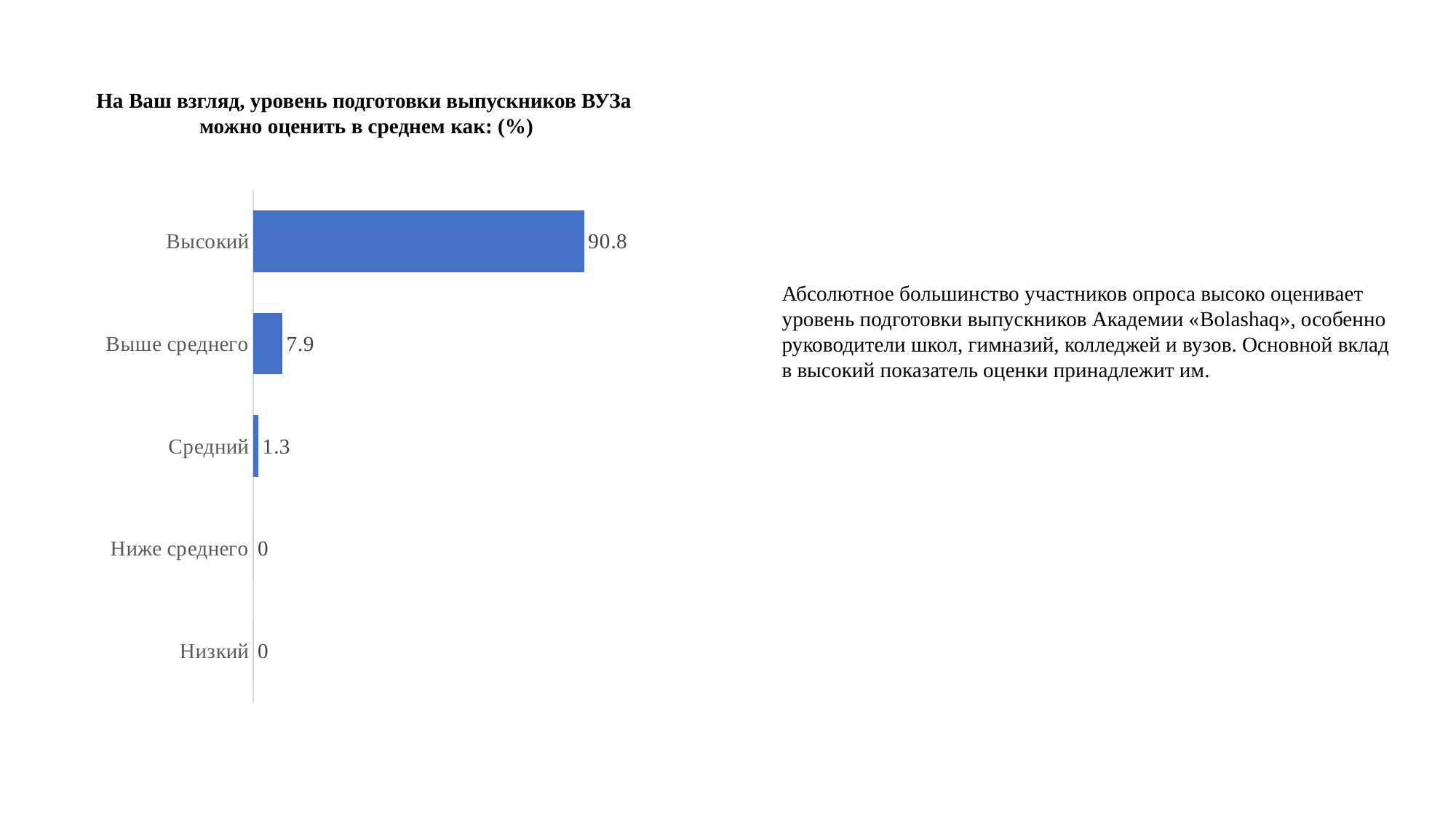
How many categories have a value of 0? 2 Which is larger, the value for Выше среднего or the value for Средний? Выше среднего Which category has the highest value? Высокий What is the value for Ниже среднего? 0 What is the difference between the values for Выше среднего and Средний? 6.6 What is the value for Средний? 1.3 What is the difference between the values for Высокий and Выше среднего? 82.9 What is the value for Выше среднего? 7.9 What kind of chart is shown on the slide? Bar chart What is the title of the chart? На Ваш взгляд, уровень подготовки выпускников ВУЗа можно оценить в среднем как: (%) How many categories are shown in the chart? 5 What is the value for Высокий? 90.8